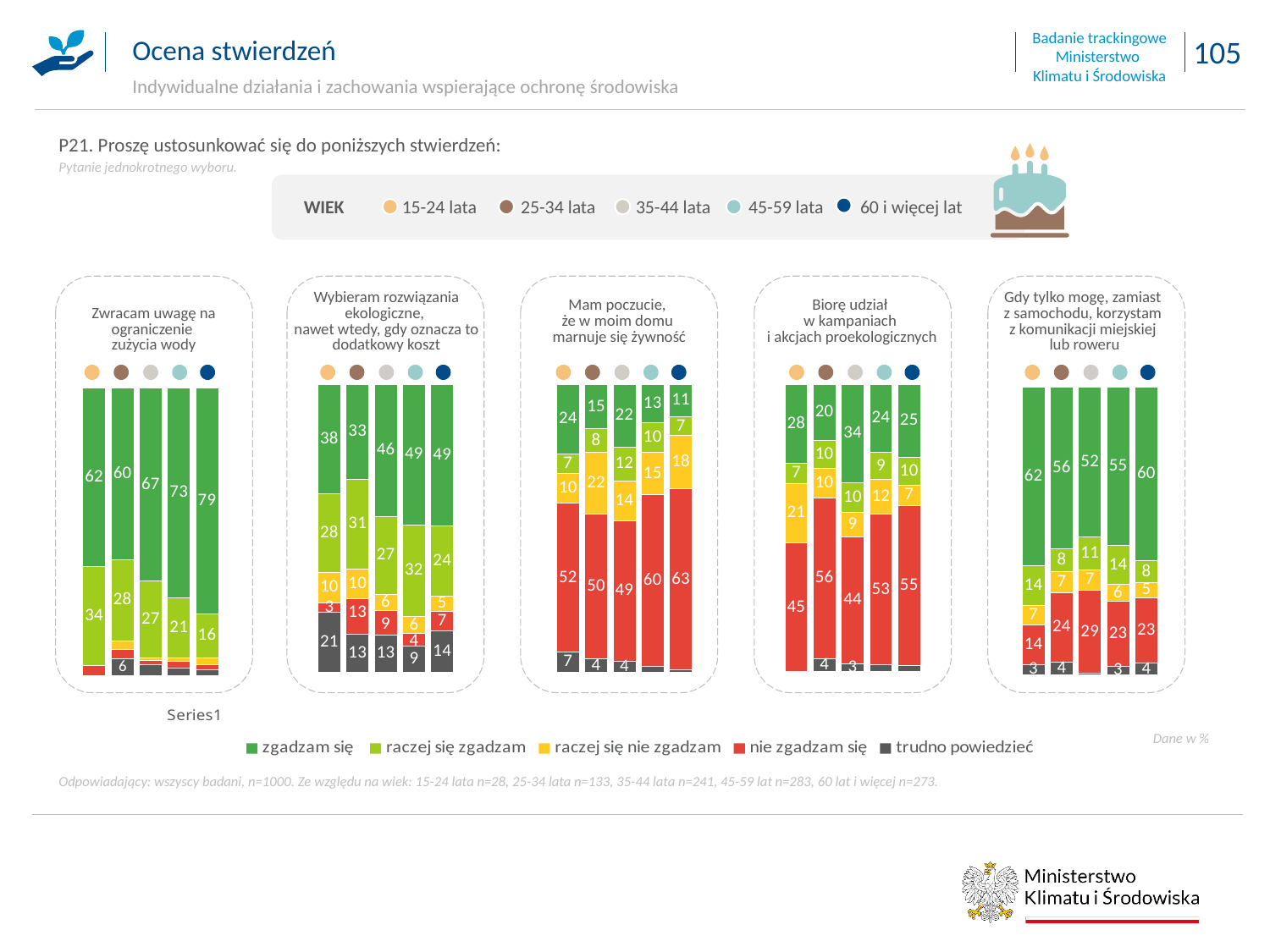
In the chart 'Zwracam uwagę na ograniczenie zużycia wody', what is the 'zgadzam się' value for the 60 i więcej lat group? 79 How many series does the legend at the bottom of the slide list? 5 What kind of chart is used for each of the five statements on the slide? Stacked bar chart In the chart 'Mam poczucie, że w moim domu marnuje się żywność', what is the 'nie zgadzam się' value for the 60 i więcej lat group? 63 In the chart 'Biorę udział w kampaniach i akcjach proekologicznych', which is larger: the 'nie zgadzam się' value for 25-34 lata or for 35-44 lata? 25-34 lata In the chart 'Gdy tylko mogę, zamiast z samochodu, korzystam z komunikacji miejskiej lub roweru', which age group has the highest 'nie zgadzam się' value? 35-44 lata In the chart 'Zwracam uwagę na ograniczenie zużycia wody', which age group has the highest 'zgadzam się' value? 60 i więcej lat In the chart 'Wybieram rozwiązania ekologiczne, nawet wtedy, gdy oznacza to dodatkowy koszt', which age group has the lowest 'zgadzam się' value? 25-34 lata In the chart 'Biorę udział w kampaniach i akcjach proekologicznych', what is the 'raczej się nie zgadzam' value for the 15-24 lata group? 21 In the chart 'Wybieram rozwiązania ekologiczne, nawet wtedy, gdy oznacza to dodatkowy koszt', what is the 'trudno powiedzieć' value for the 15-24 lata group? 21 In the chart 'Wybieram rozwiązania ekologiczne, nawet wtedy, gdy oznacza to dodatkowy koszt', what is the total of the stacked bar for the 15-24 lata group? 100 In the chart 'Mam poczucie, że w moim domu marnuje się żywność', what is the difference between the 'zgadzam się' values for 15-24 lata and 60 i więcej lat? 13